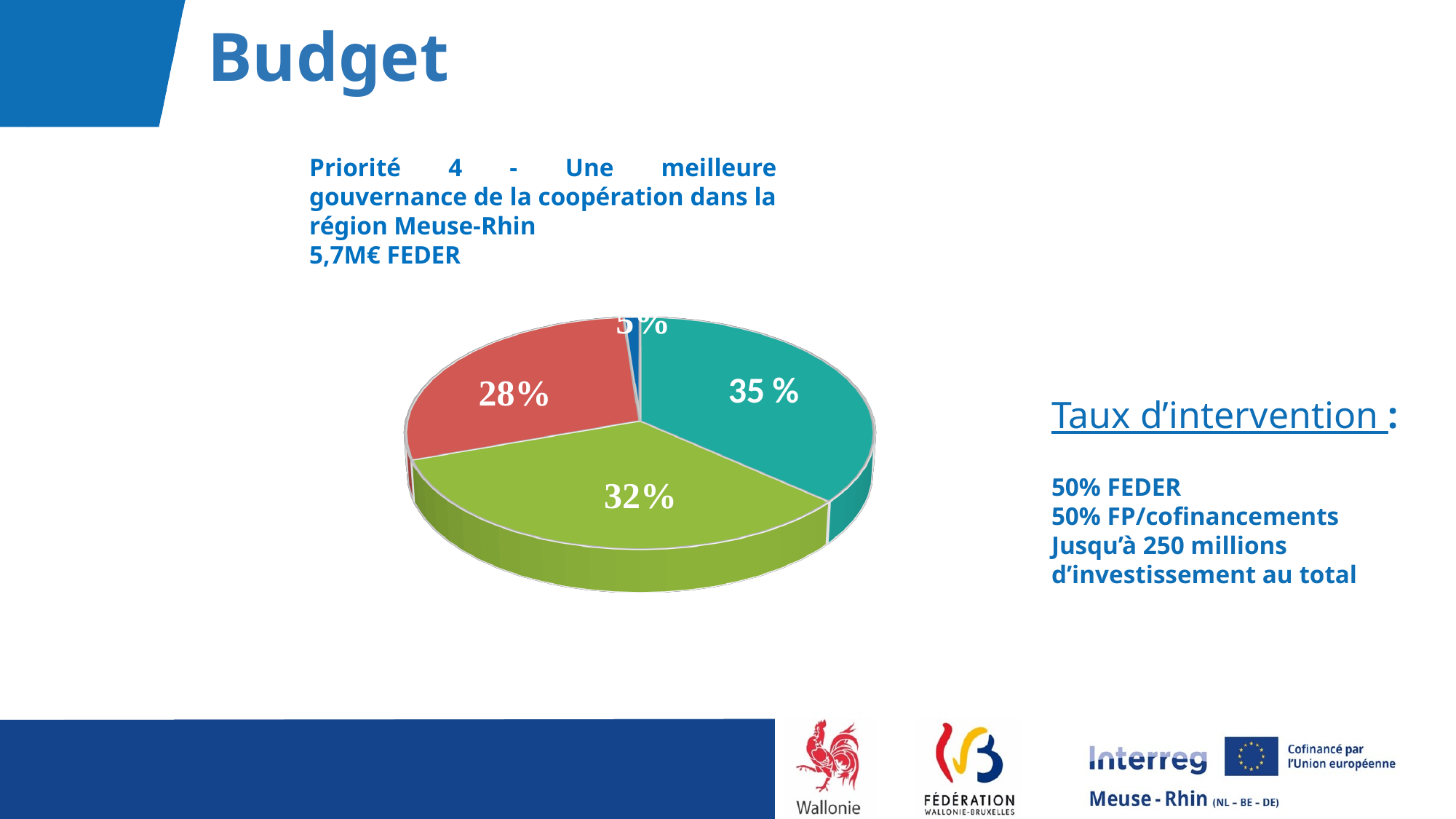
What percentage is shown on the teal slice of the pie chart? 35 % What kind of chart is shown on the slide? pie chart What is the difference between the green slice and the blue slice of the pie chart? 27% Which colour is the largest slice of the pie chart? teal What is the value of the largest slice in the pie chart? 35 % What percentage is shown on the green slice of the pie chart? 32% Which slice is larger in the pie chart, the green slice or the red slice? green slice How many slices does the pie chart have? 4 What is the value of the smallest slice in the pie chart? 5% What is the FEDER amount stated above the pie chart for Priorité 4? 5,7M€ FEDER What percentage is shown on the red slice of the pie chart? 28% What is the difference between the teal slice and the red slice of the pie chart? 7%